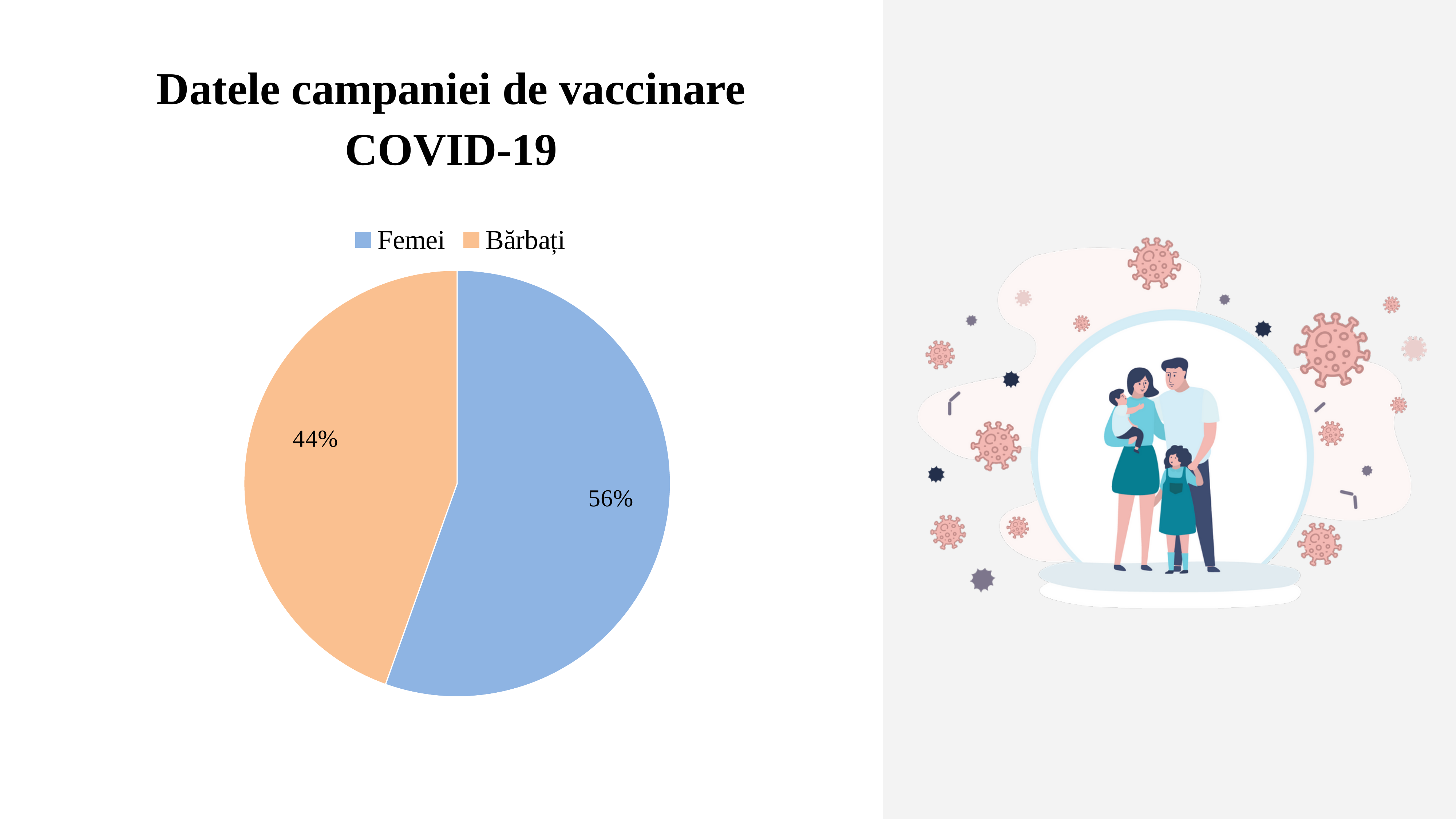
What kind of chart is shown on the slide? Pie chart What colour is the Bărbați slice? Orange How many entries does the legend list? 2 Which category has the smallest slice of the pie? Bărbați Which category has the largest slice of the pie? Femei How many slices does the pie chart have? 2 What share of the pie does Femei represent? 56% What is the title shown above the chart? Datele campaniei de vaccinare COVID-19 What is the difference in percentage points between the Femei and Bărbați slices? 12 Which slice is larger, Femei or Bărbați? Femei What share of the pie does Bărbați represent? 44%